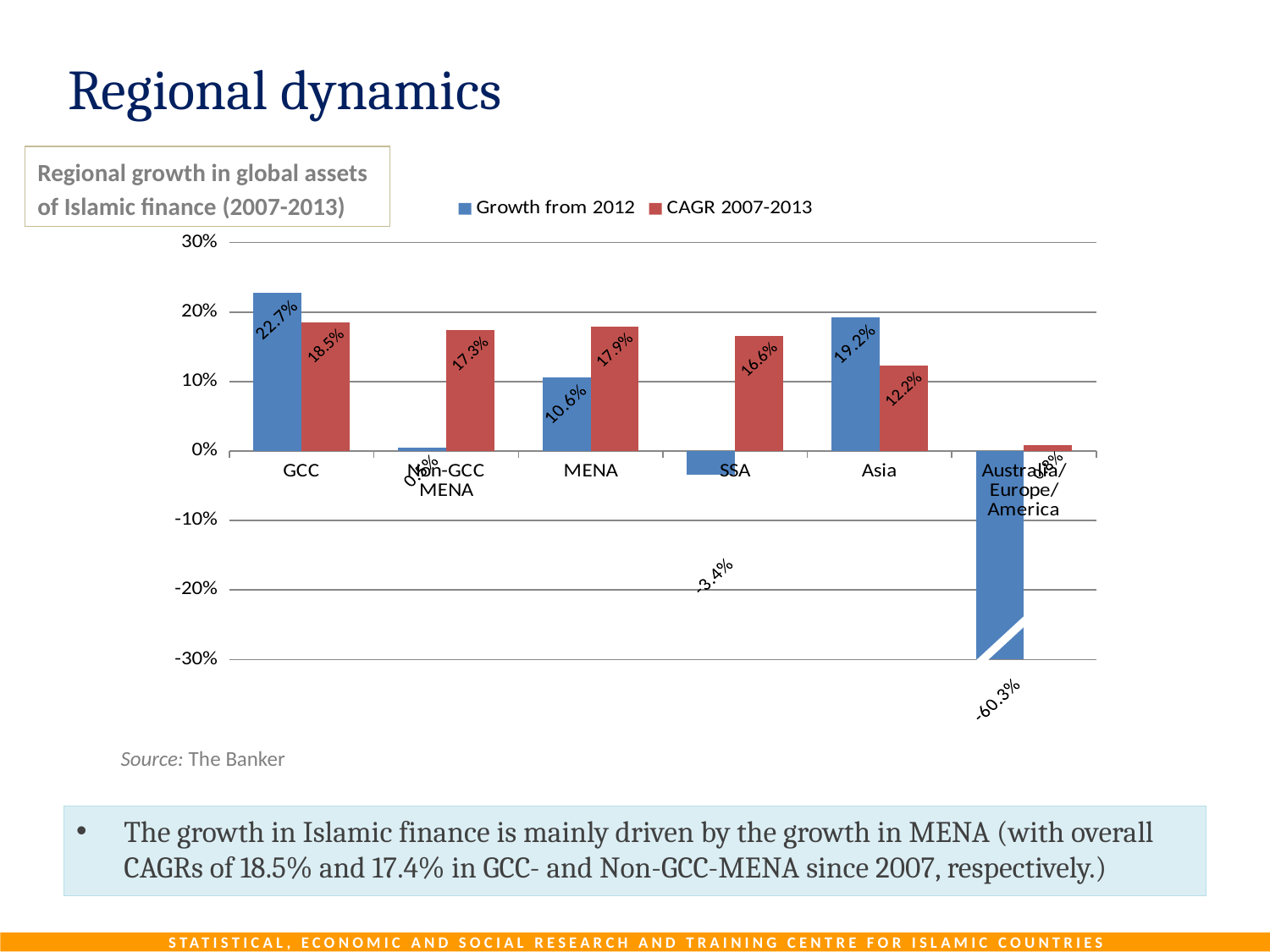
What is the Growth from 2012 value for Australia/Europe/America? -60.3% How many regions are shown on the x axis of the chart? 6 What is the difference between the Growth from 2012 and the CAGR 2007-2013 for Asia? 7.0 percentage points Which region has the highest CAGR 2007-2013? GCC What is the CAGR 2007-2013 value for MENA? 17.9% Which region has the lowest Growth from 2012? Australia/Europe/America What is the Growth from 2012 value for SSA? -3.4% What is the Growth from 2012 value for GCC? 22.7% Which region has the highest Growth from 2012? GCC For Asia, which is larger: Growth from 2012 or CAGR 2007-2013? Growth from 2012 How many series does the legend list? 2 Is the CAGR 2007-2013 value for SSA greater or less than 10%? greater